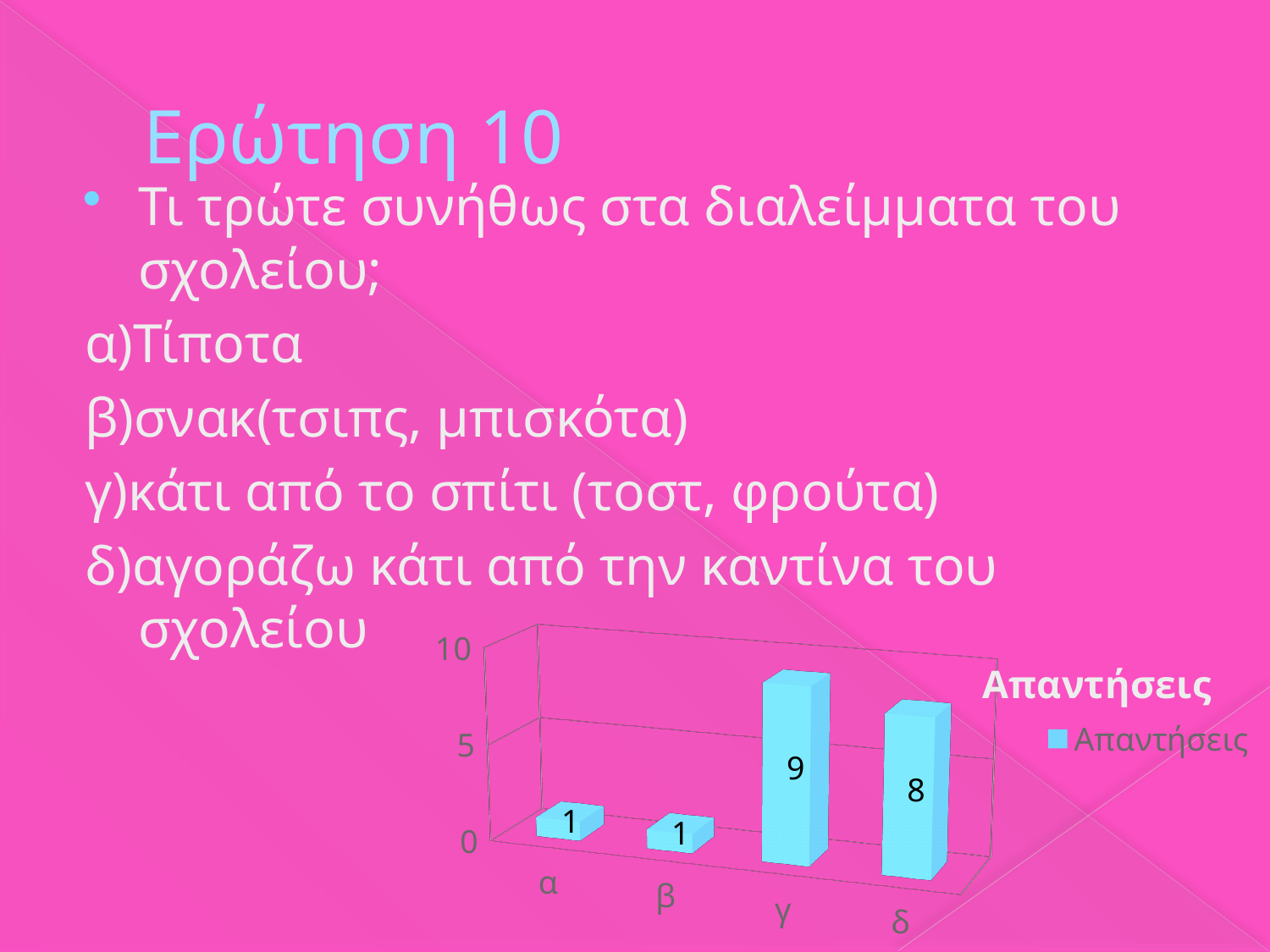
What is the value for category γ? 9 What is the difference between the values for γ and δ? 1 Is the value for β greater or less than 5? less What kind of chart is shown? bar chart Is the value for γ greater or less than 5? greater How many categories are shown on the x axis? 4 What is the value for category α? 1 Which category has the highest value? γ What is the value for category δ? 8 What is the title of the chart? Απαντήσεις Which is larger, the value for β or the value for δ? δ How many series does the legend list? 1